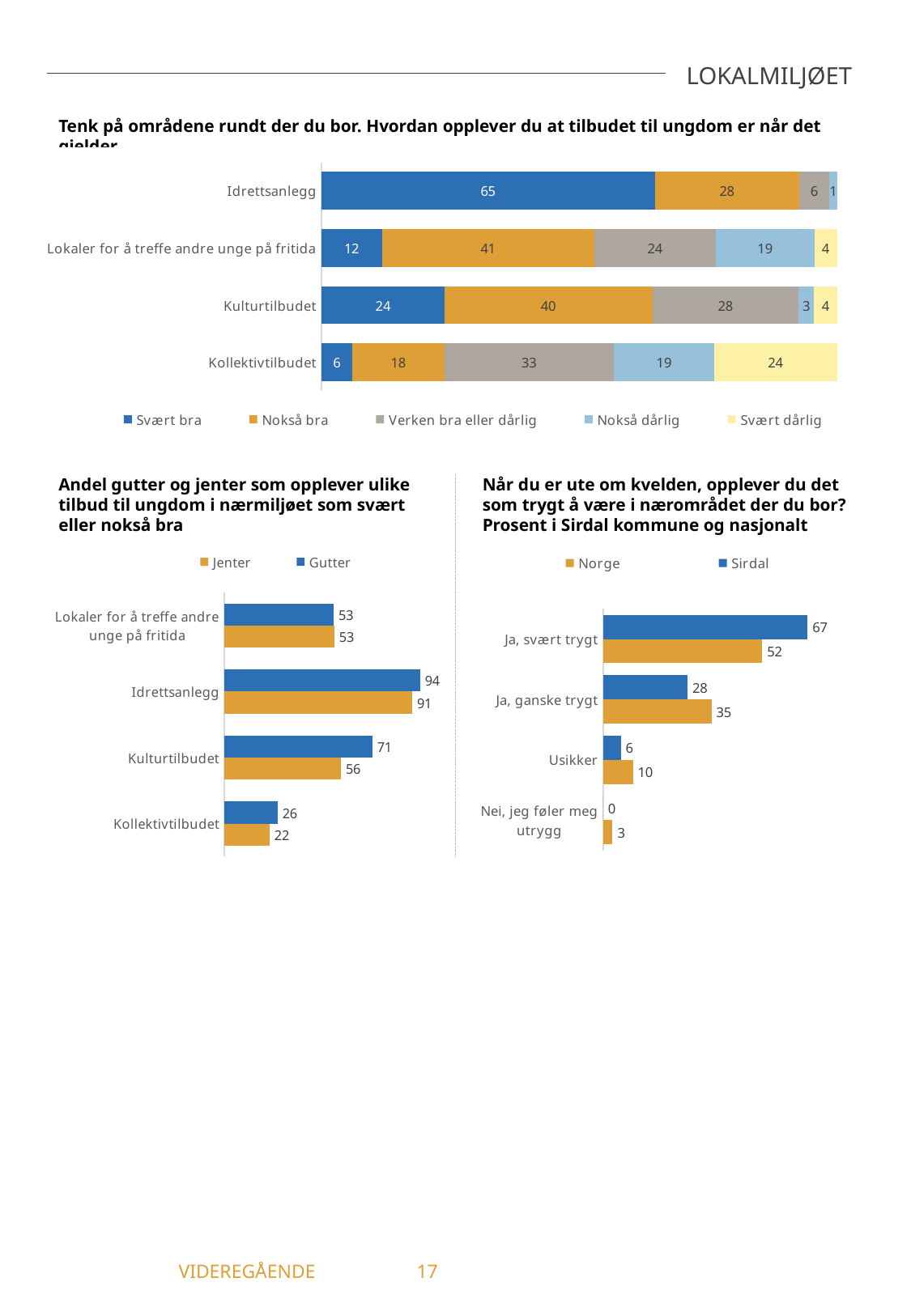
In the bottom-right chart 'Når du er ute om kvelden...', what is the Sirdal value for 'Ja, svært trygt'? 67 What kind of chart is the top chart on the slide? Stacked bar chart In the bottom-right chart 'Når du er ute om kvelden...', how many categories are shown? 4 In the top stacked bar chart, what is the 'Svært dårlig' value for Kollektivtilbudet? 24 In the top stacked bar chart, what is the total of the Kollektivtilbudet bar (6 + 18 + 33 + 19 + 24)? 100 In the bottom-left chart 'Andel gutter og jenter...', what is the difference between Gutter and Jenter for Kulturtilbudet? 15 In the bottom-left chart 'Andel gutter og jenter...', what is the Gutter value for Kulturtilbudet? 71 In the top stacked bar chart, what percentage rated Idrettsanlegg as 'Svært bra'? 65 In the top stacked bar chart, how many series does the legend list? 5 In the bottom-right chart 'Når du er ute om kvelden...', which is larger for 'Ja, ganske trygt': Norge or Sirdal? Norge In the bottom-left chart 'Andel gutter og jenter...', which category has the lowest Jenter value? Kollektivtilbudet In the top stacked bar chart, which category has the highest 'Svært bra' value? Idrettsanlegg